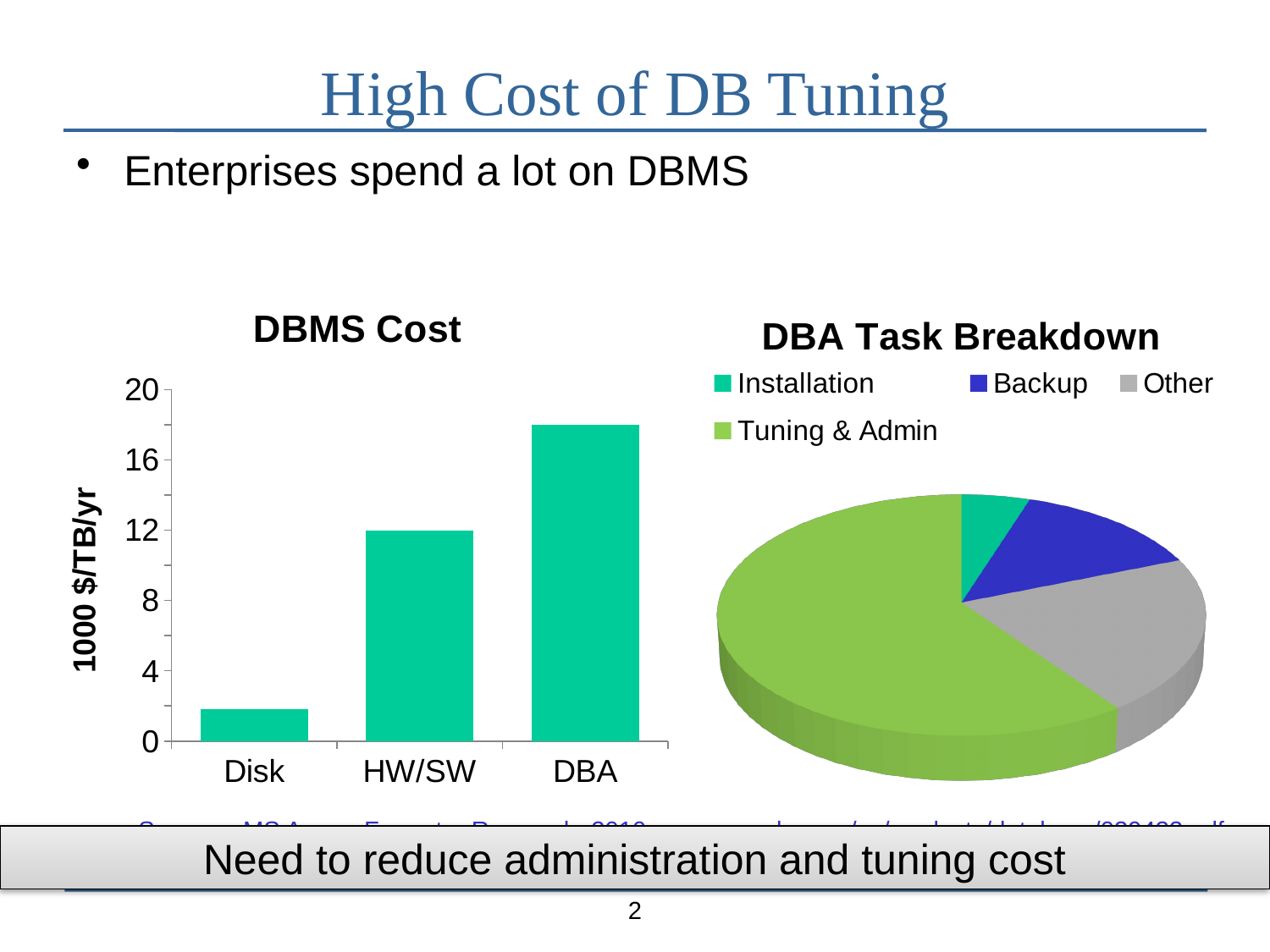
In the DBMS Cost chart, which category has the highest value? DBA In the DBMS Cost chart, which is larger, the value for HW/SW or the value for Disk? HW/SW In the DBMS Cost chart, what is the value for HW/SW? 12 In the DBMS Cost chart, is the value for DBA greater or less than 16? greater In the DBMS Cost chart, which category has the lowest value? Disk In the DBMS Cost chart, do the values rise or fall from Disk to DBA along the x axis? rise In the DBMS Cost chart, is the value for Disk greater or less than 4? less What kind of chart is the DBMS Cost chart? bar chart How many categories are shown on the x axis of the DBMS Cost chart? 3 How many entries does the legend of the DBA Task Breakdown chart list? 4 What kind of chart is the DBA Task Breakdown chart? pie chart In the DBA Task Breakdown chart, which slice is the largest? Tuning & Admin